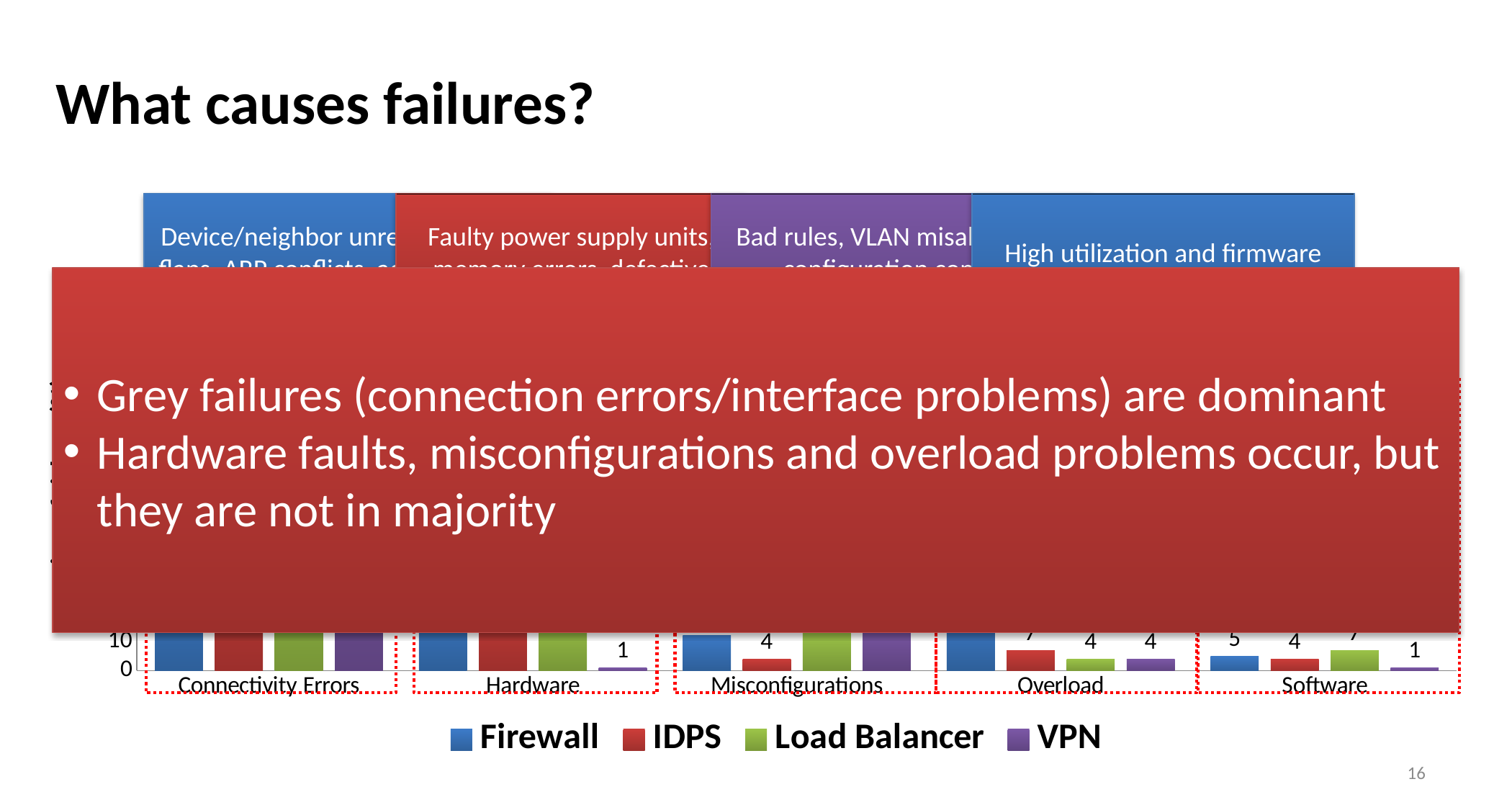
How many categories are shown on the x axis of the chart? 5 How many series does the chart legend list? 4 Which colour represents Load Balancer in the chart legend? green What is the difference between the Firewall value and the VPN value in the Software category? 4 What is the value for VPN in the Hardware category? 1 Is the value for Firewall in the Connectivity Errors category greater or less than 10? greater What is the value for Firewall in the Software category? 5 What kind of chart is shown on the slide? bar chart What is the value for Load Balancer in the Overload category? 4 In the Software category, which is larger: the Firewall value or the VPN value? Firewall What is the value for VPN in the Software category? 1 What is the value for IDPS in the Misconfigurations category? 4